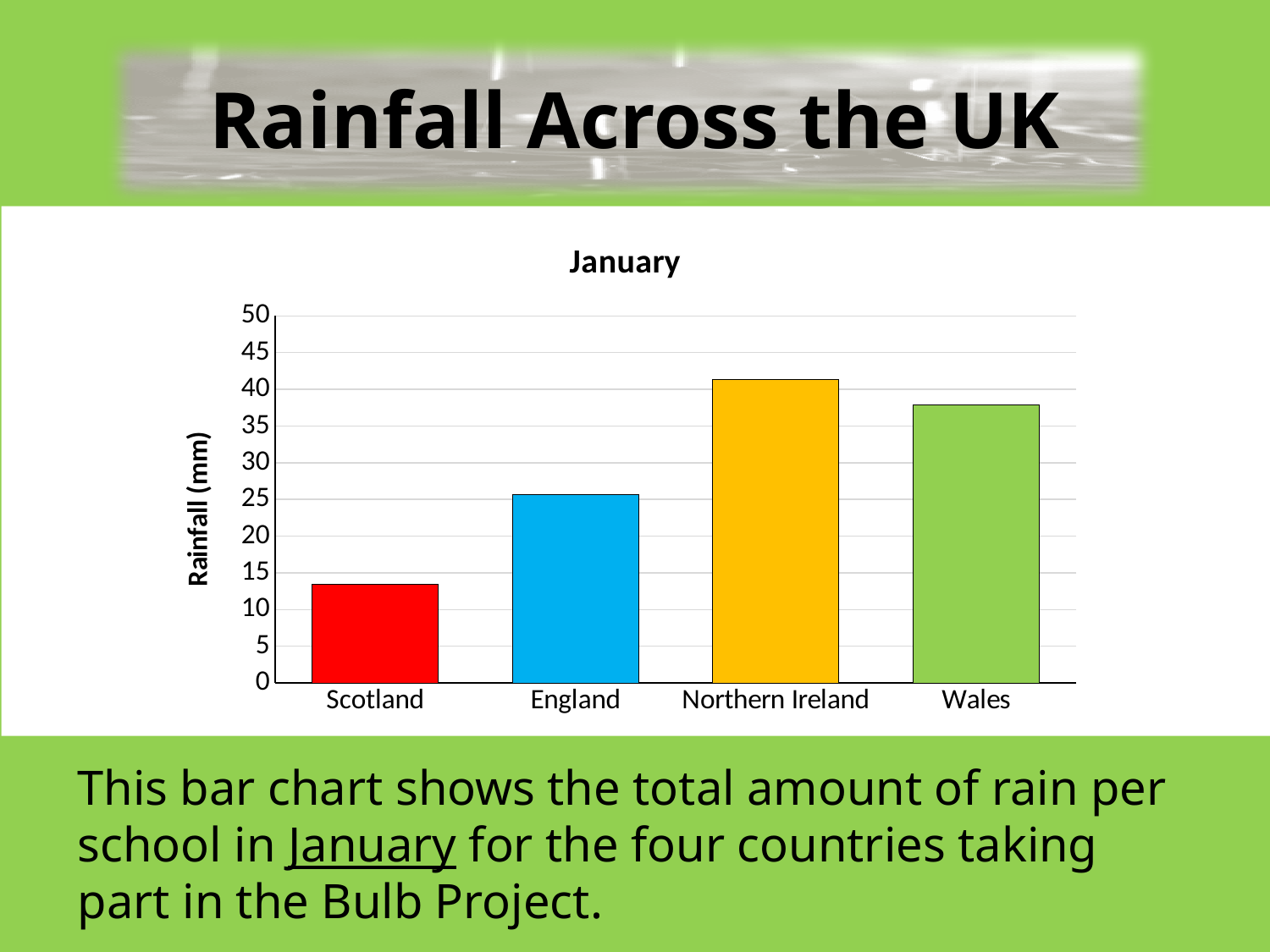
Is the value for Northern Ireland greater or less than 40? greater What is the title of the chart? January Which has the lower rainfall, Scotland or England? Scotland Which has the higher rainfall, England or Wales? Wales Is the value for Wales greater or less than 35? greater Is the value for England greater or less than 20? greater How many countries are shown on the chart? 4 Which country has the lowest rainfall on the chart? Scotland Which country has the highest rainfall on the chart? Northern Ireland What kind of chart is shown on the slide? bar chart What is the label on the vertical axis of the chart? Rainfall (mm)